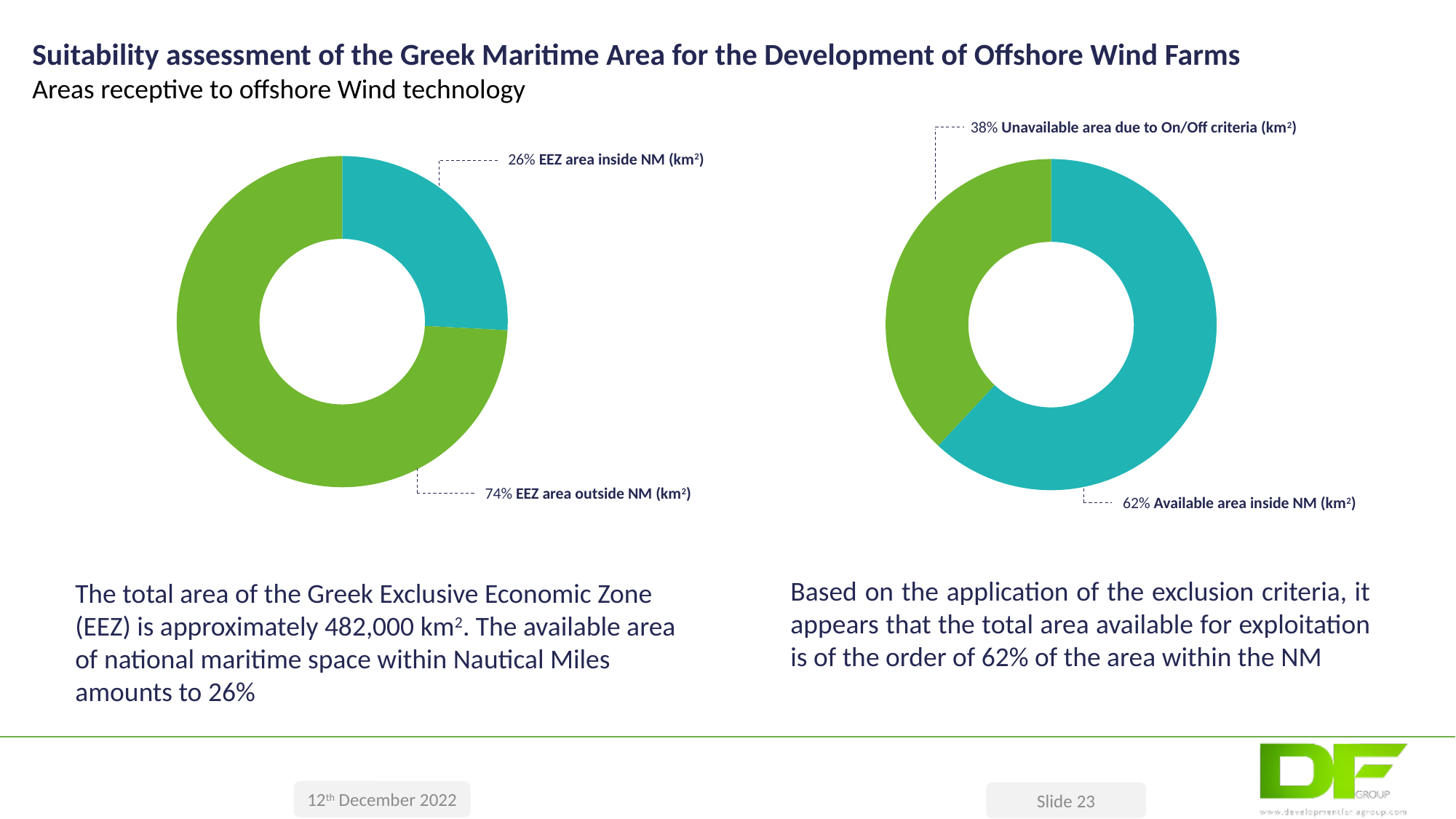
In the left chart, what share is labelled for EEZ area outside NM (km²)? 74% In the right chart, which is larger: Available area inside NM or Unavailable area due to On/Off criteria? Available area inside NM What kind of chart is the right chart? Doughnut (pie) chart In the right chart, what share is labelled for Unavailable area due to On/Off criteria (km²)? 38% In the left chart, what colour is the EEZ area inside NM slice? Teal (blue-green) In the right chart, what share is labelled for Available area inside NM (km²)? 62% How many slices does the left chart have? 2 In the right chart, what is the difference in percentage points between Available area inside NM and Unavailable area due to On/Off criteria? 24 In the right chart, which slice is the smallest? Unavailable area due to On/Off criteria (km²) In the left chart, what is the difference in percentage points between EEZ area outside NM and EEZ area inside NM? 48 In the left chart, what share is labelled for EEZ area inside NM (km²)? 26% In the left chart, which slice is the largest? EEZ area outside NM (km²)